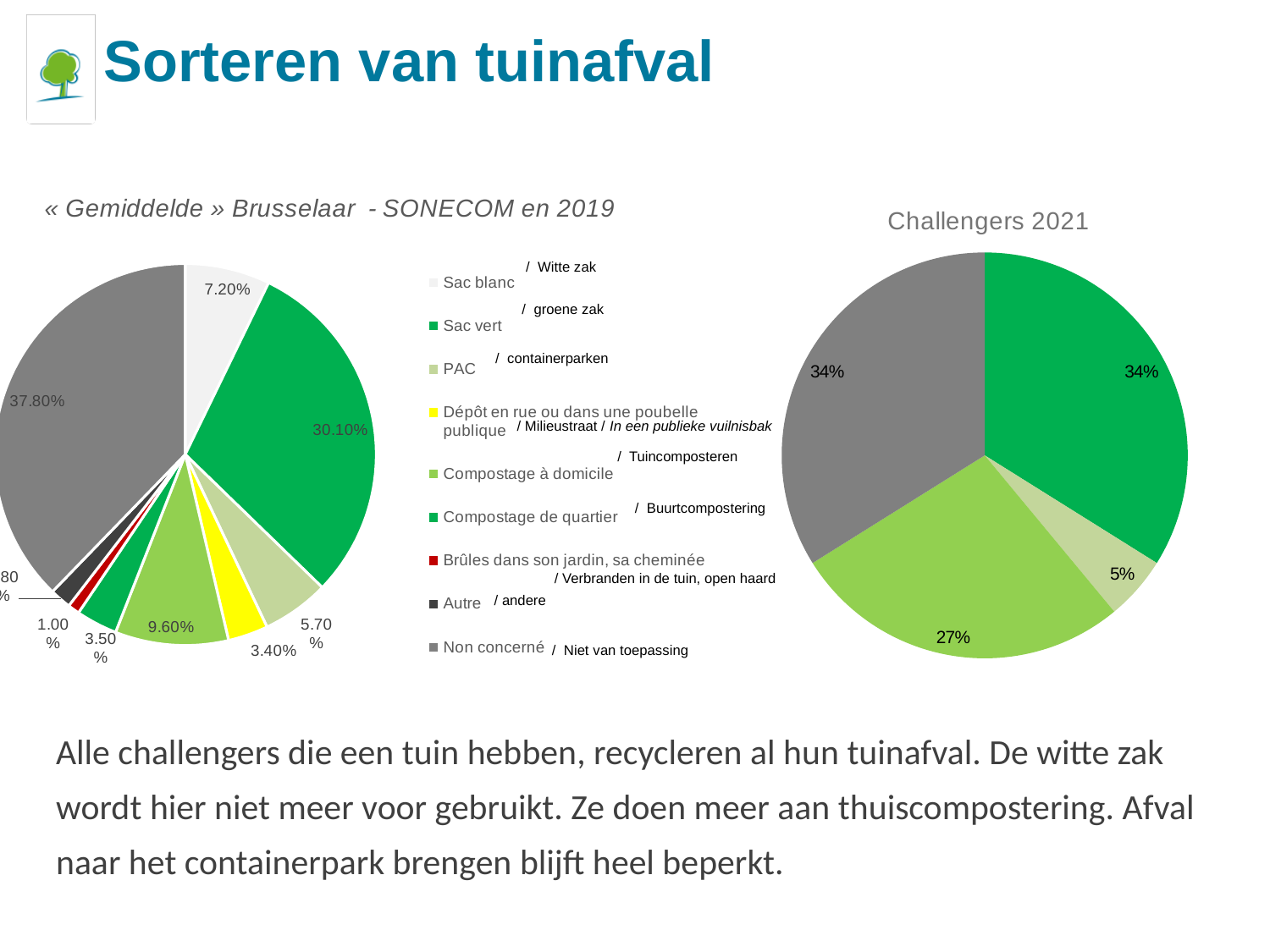
In the Challengers 2021 pie chart, what share is shown for Sac vert (groene zak)? 34% In the « Gemiddelde » Brusselaar - SONECOM en 2019 pie chart, what is the difference between the Sac vert share and the Compostage à domicile share? 20.50% In the « Gemiddelde » Brusselaar - SONECOM en 2019 pie chart, which category has the largest slice? Non concerné In the « Gemiddelde » Brusselaar - SONECOM en 2019 pie chart, what share is shown for Sac blanc (Witte zak)? 7.20% In the « Gemiddelde » Brusselaar - SONECOM en 2019 pie chart, what share is shown for Sac vert (groene zak)? 30.10% In the Challengers 2021 pie chart, what share is shown for Compostage à domicile (Tuincomposteren)? 27% What kind of chart is used for Challengers 2021? Pie chart In the « Gemiddelde » Brusselaar - SONECOM en 2019 pie chart, what share is shown for Non concerné (Niet van toepassing)? 37.80% In the « Gemiddelde » Brusselaar - SONECOM en 2019 pie chart, which is larger: the PAC share or the Dépôt en rue ou dans une poubelle publique share? PAC In the Challengers 2021 pie chart, what share is shown for PAC (containerparken)? 5% In the Challengers 2021 pie chart, which category has the smallest slice? PAC How many slices does the Challengers 2021 pie chart have? 4